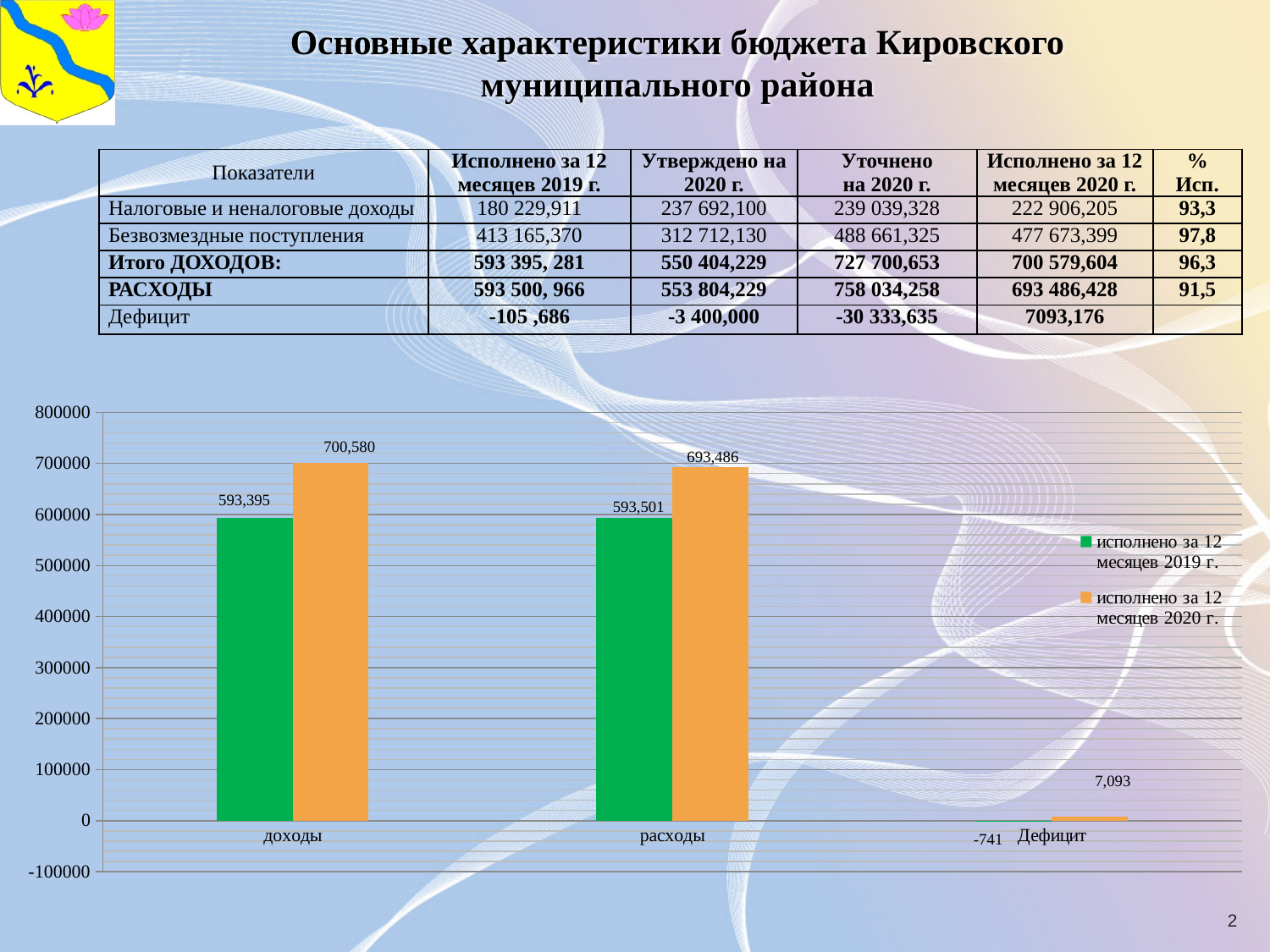
What is the value for доходы in the series исполнено за 12 месяцев 2019 г.? 593,395 What is the value for доходы in the series исполнено за 12 месяцев 2020 г.? 700,580 What is the difference between the 2020 and 2019 values for доходы? 107,185 What is the value for расходы in the series исполнено за 12 месяцев 2020 г.? 693,486 Which category has the highest value in the series исполнено за 12 месяцев 2020 г.? доходы Which series is shown in green in the chart? исполнено за 12 месяцев 2019 г. Which category has the lowest value in the series исполнено за 12 месяцев 2020 г.? Дефицит What is the value for Дефицит in the series исполнено за 12 месяцев 2020 г.? 7,093 What is the value for Дефицит in the series исполнено за 12 месяцев 2019 г.? -741 What type of chart is shown on the slide? bar chart How many series does the chart legend list? 2 How many categories are shown on the x axis of the chart? 3